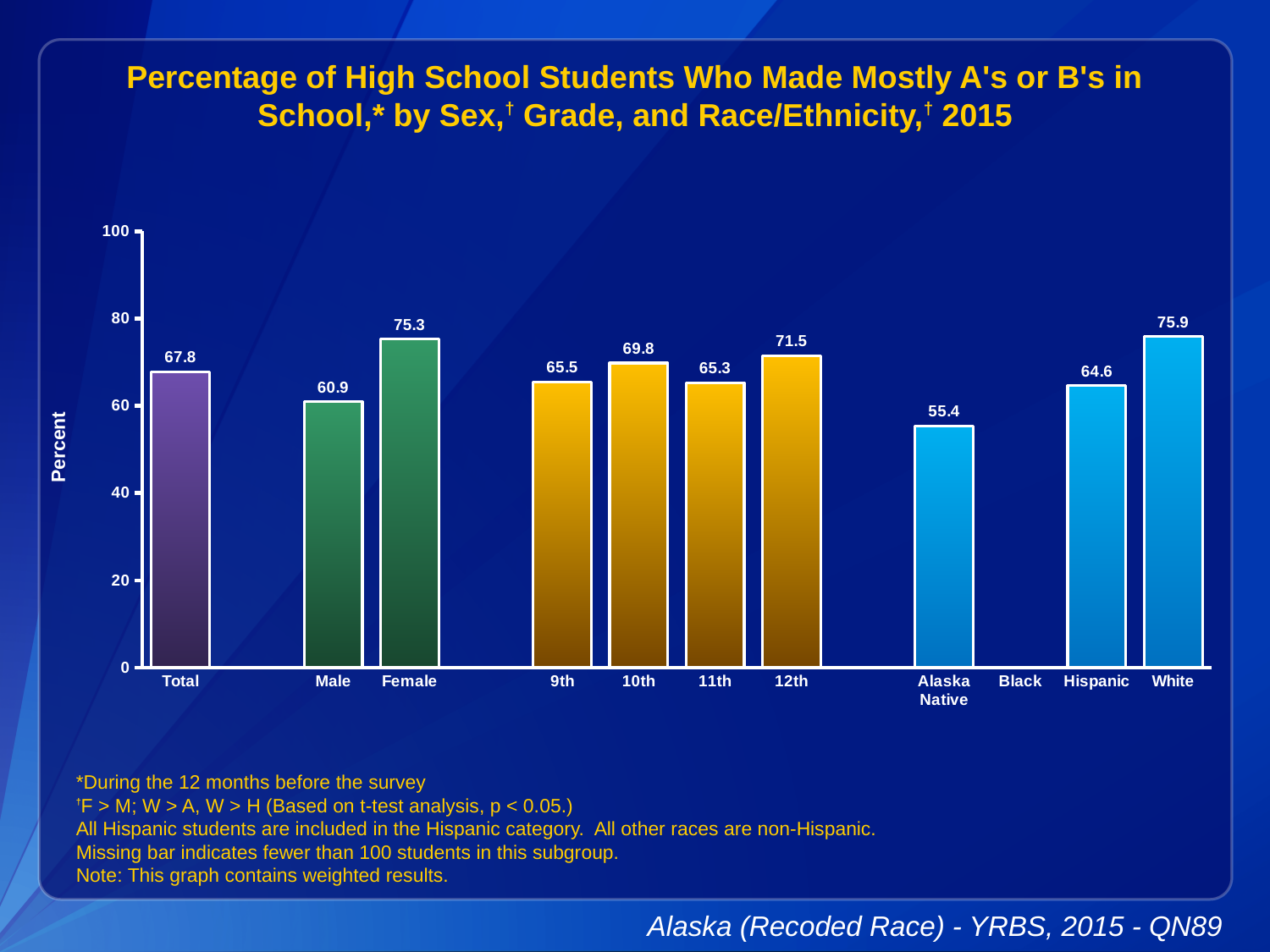
What is the value for 12th grade? 71.5 Which category has the lowest value among the bars shown? Alaska Native Which is larger, the value for 10th grade or the value for 11th grade? 10th What kind of chart is shown? bar chart Which category has the highest value? White What is the label on the y axis? Percent What is the difference between the Female and Male values? 14.4 What is the value for Female? 75.3 Which category has no bar shown? Black How many bars are plotted on the chart? 11 What is the value for Alaska Native? 55.4 Is the value for Hispanic greater or less than 60? greater